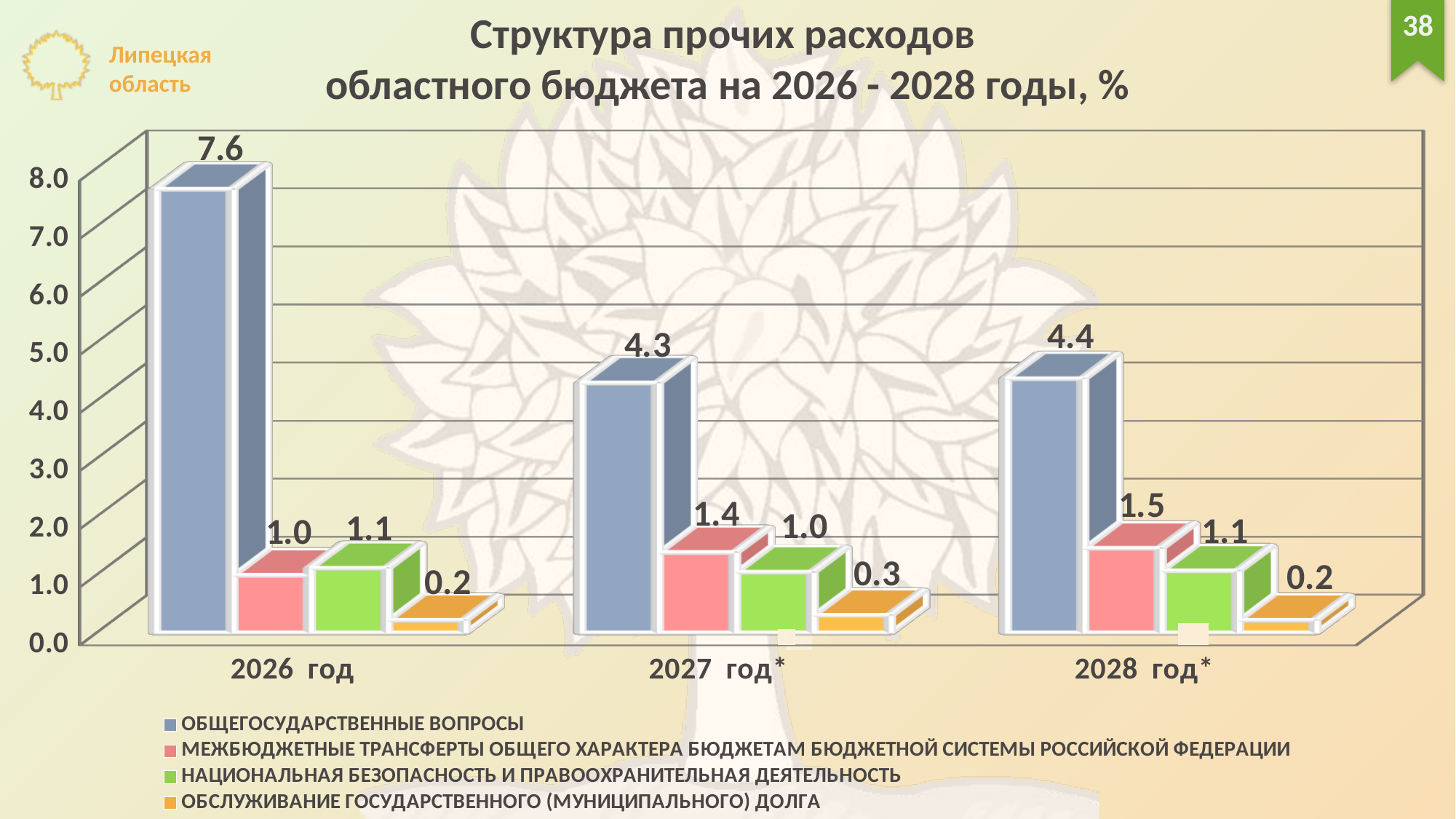
How many series does the legend list? 4 How many year categories are shown on the x axis? 3 Which is larger: ОБЩЕГОСУДАРСТВЕННЫЕ ВОПРОСЫ in 2027 год* or in 2028 год*? 2028 год* In which year is the value for ОБЩЕГОСУДАРСТВЕННЫЕ ВОПРОСЫ highest? 2026 год What is the value for ОБЩЕГОСУДАРСТВЕННЫЕ ВОПРОСЫ in 2026 год? 7.6 What is the difference between the ОБЩЕГОСУДАРСТВЕННЫЕ ВОПРОСЫ values for 2026 год and 2027 год*? 3.3 In which year is the value for ОБСЛУЖИВАНИЕ ГОСУДАРСТВЕННОГО (МУНИЦИПАЛЬНОГО) ДОЛГА highest? 2027 год* What is the value for НАЦИОНАЛЬНАЯ БЕЗОПАСНОСТЬ И ПРАВООХРАНИТЕЛЬНАЯ ДЕЯТЕЛЬНОСТЬ in 2027 год*? 1.0 What is the value for ОБСЛУЖИВАНИЕ ГОСУДАРСТВЕННОГО (МУНИЦИПАЛЬНОГО) ДОЛГА in 2028 год*? 0.2 What kind of chart is shown on the slide? Bar chart Does the value for МЕЖБЮДЖЕТНЫЕ ТРАНСФЕРТЫ ОБЩЕГО ХАРАКТЕРА БЮДЖЕТАМ БЮДЖЕТНОЙ СИСТЕМЫ РОССИЙСКОЙ ФЕДЕРАЦИИ rise or fall from 2026 год to 2028 год*? Rise What is the value for МЕЖБЮДЖЕТНЫЕ ТРАНСФЕРТЫ ОБЩЕГО ХАРАКТЕРА БЮДЖЕТАМ БЮДЖЕТНОЙ СИСТЕМЫ РОССИЙСКОЙ ФЕДЕРАЦИИ in 2027 год*? 1.4